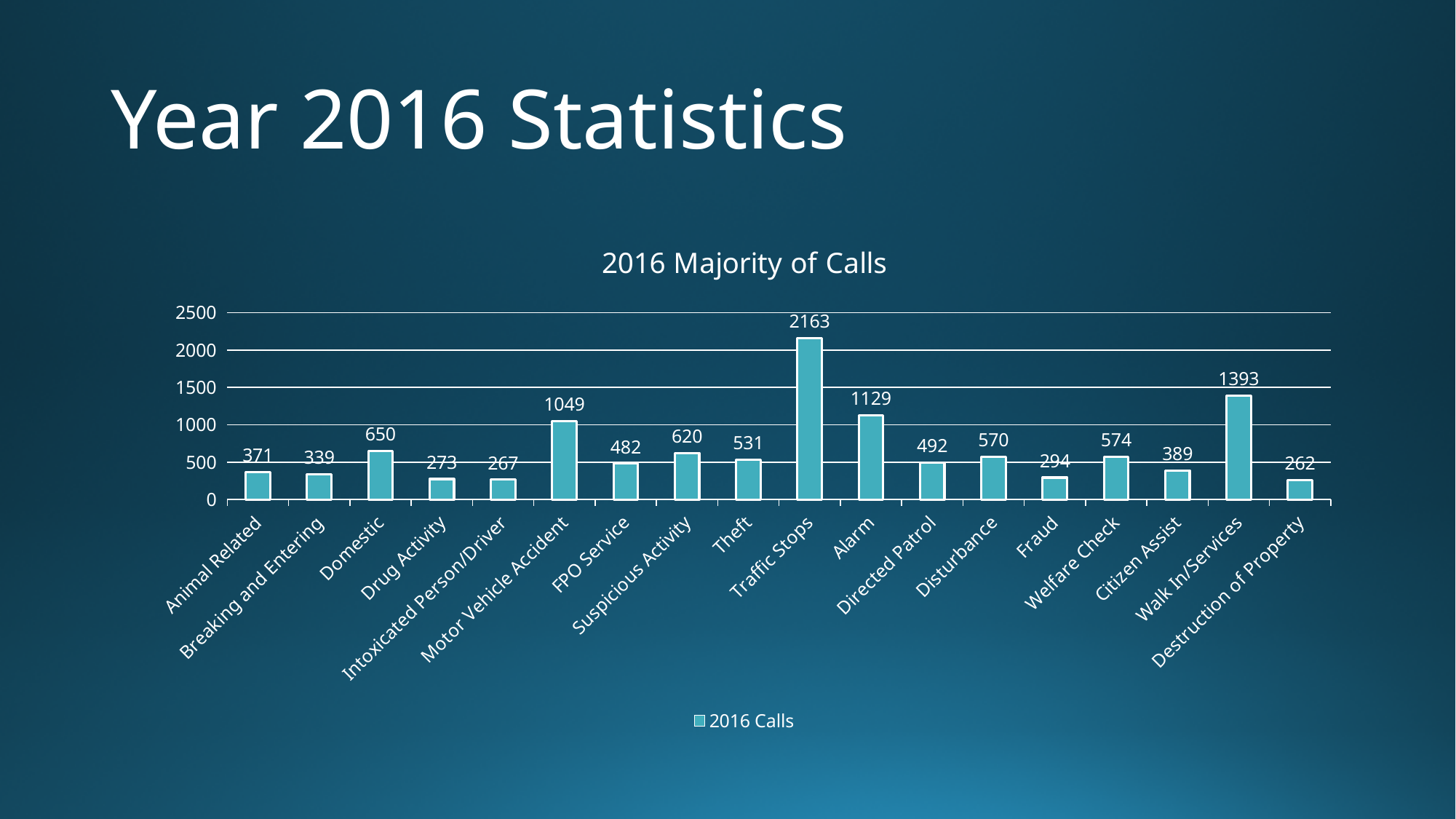
What is the difference between the values for Domestic and Suspicious Activity? 30 How many call categories are plotted in the chart? 18 Which category has the highest number of calls? Traffic Stops What is the value for Traffic Stops? 2163 Which is larger, the value for Alarm or the value for Motor Vehicle Accident? Alarm What is the value for Intoxicated Person/Driver? 267 How many series does the legend list? 1 What is the difference between the values for Traffic Stops and Walk In/Services? 770 What is the title of the chart? 2016 Majority of Calls Which category has the lowest number of calls? Destruction of Property What is the value for Walk In/Services? 1393 What type of chart is shown on the slide? bar chart